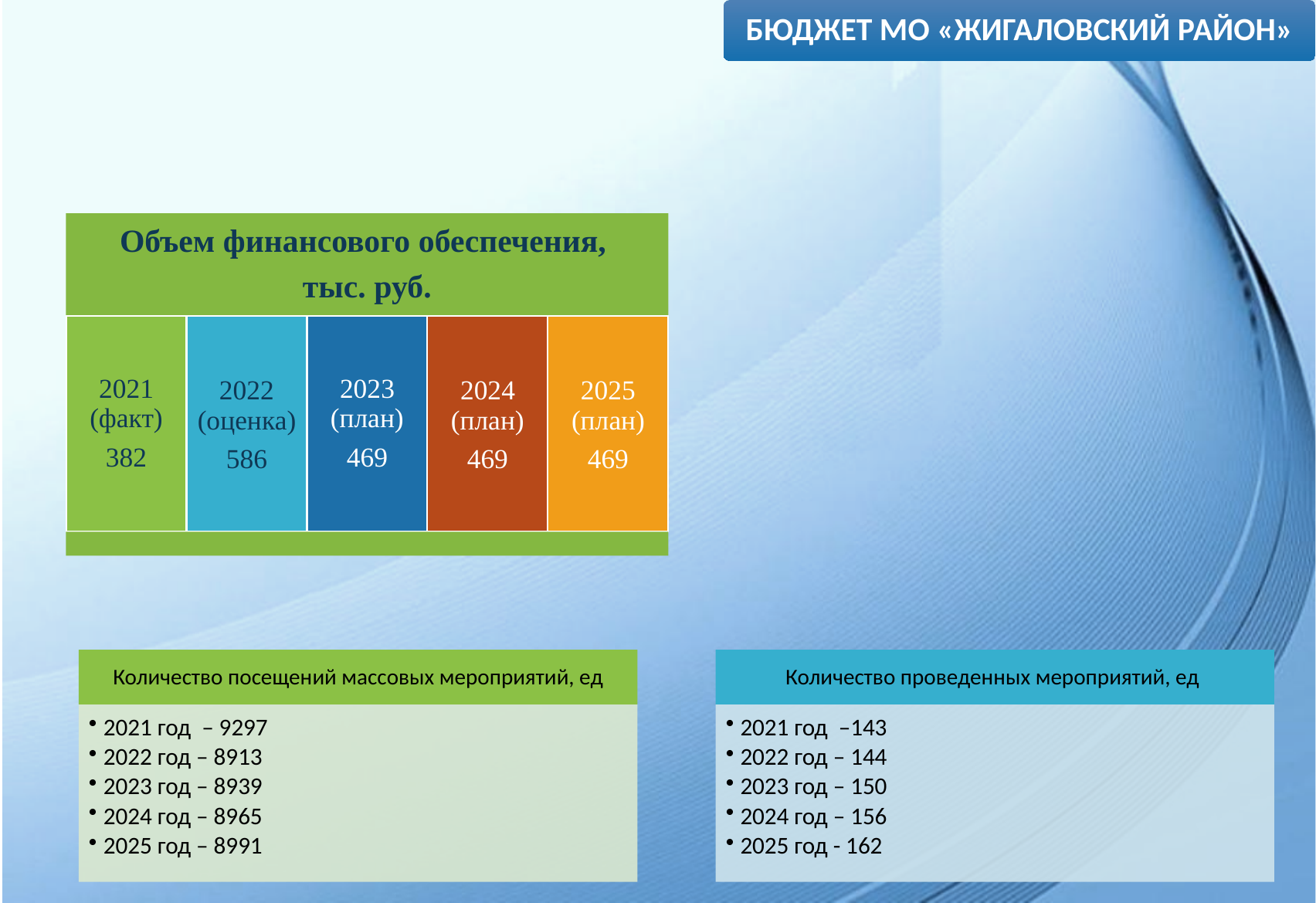
In the 'Объем финансового обеспечения, тыс. руб.' graphic, what is the difference between the 2022 value and the 2021 value? 204 In the 'Объем финансового обеспечения, тыс. руб.' graphic, which year has the lowest value? 2021 (факт) In the 'Объем финансового обеспечения, тыс. руб.' graphic, what is the difference between the 2022 value and the 2023 value? 117 In the 'Объем финансового обеспечения, тыс. руб.' graphic, which is larger: the value for 2022 or the value for 2024? 2022 In the 'Объем финансового обеспечения, тыс. руб.' graphic, what is the value for 2021 (факт)? 382 In the 'Объем финансового обеспечения, тыс. руб.' graphic, what colour is the block for 2024 (план)? Orange-brown (dark orange) In the 'Объем финансового обеспечения, тыс. руб.' graphic, which year has the highest value? 2022 (оценка) How many years are shown in the 'Объем финансового обеспечения, тыс. руб.' graphic? 5 In the 'Объем финансового обеспечения, тыс. руб.' graphic, what is the value for 2022 (оценка)? 586 In the 'Объем финансового обеспечения, тыс. руб.' graphic, what is the value for 2025 (план)? 469 In the 'Объем финансового обеспечения, тыс. руб.' graphic, what is the value for 2023 (план)? 469 What unit is stated in the title of the 'Объем финансового обеспечения' graphic? тыс. руб.